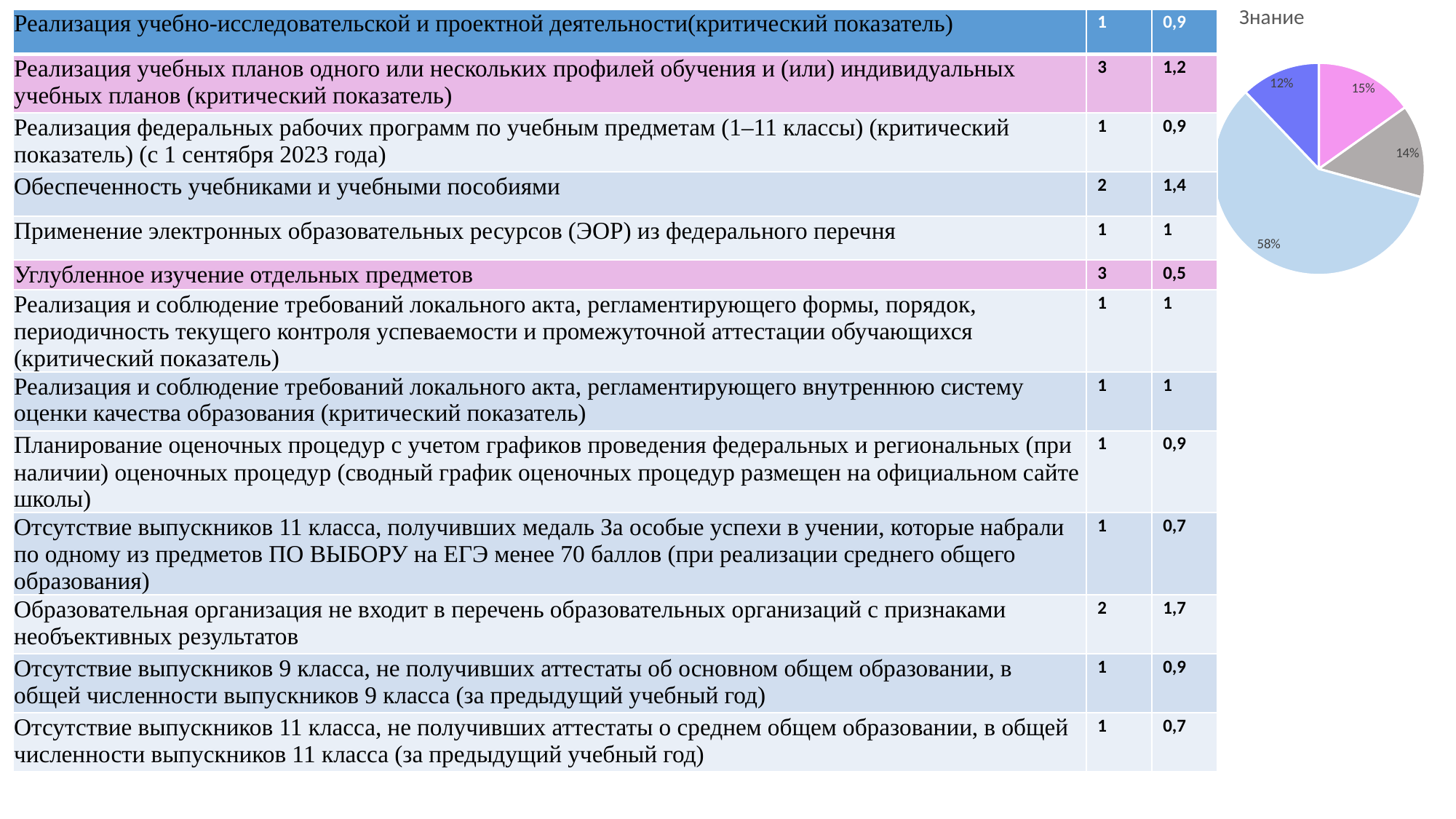
What is the title of the pie chart? Знание What percentage is labelled on the light blue slice of the pie chart? 58% What percentage is labelled on the grey slice of the pie chart? 14% What percentage is labelled on the pink slice of the pie chart? 15% What is the largest share shown in the pie chart? 58% What percentage is labelled on the purple slice of the pie chart? 12% Which slice is larger in the pie chart, the pink slice or the grey slice? the pink slice What colour is the largest slice of the pie chart? light blue What is the difference in percentage points between the largest slice (58%) and the smallest slice (12%) of the pie chart? 46 How many slices does the pie chart have? 4 What is the smallest share shown in the pie chart? 12% What kind of chart is shown on the slide? pie chart